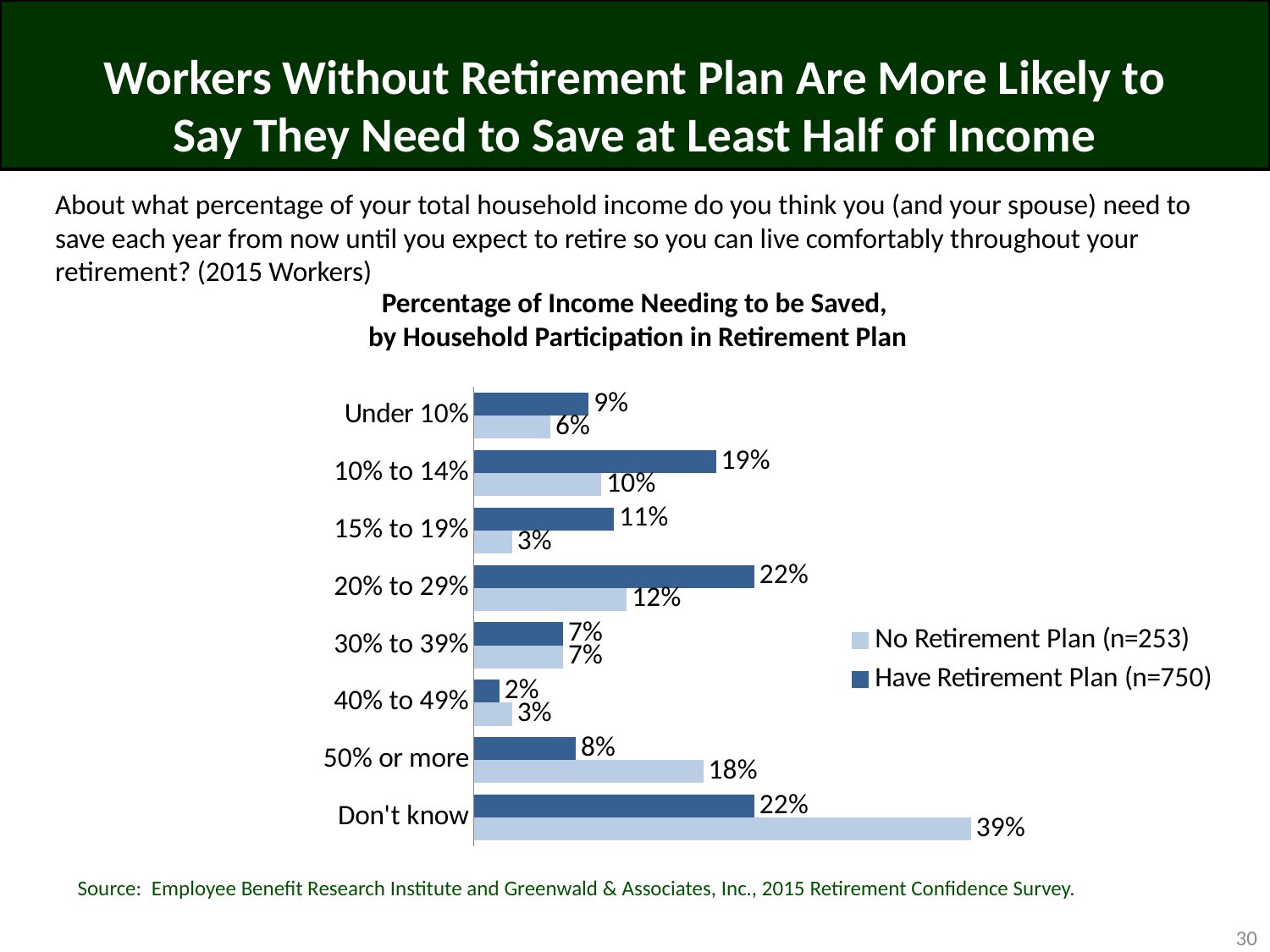
Which category has the lowest value for the Have Retirement Plan series? 40% to 49% What type of chart is shown on the slide? Bar chart How many response categories are shown on the chart? 8 What is the value for the Have Retirement Plan series in the 10% to 14% category? 19% Which category has the highest value for the No Retirement Plan series? Don't know What percentage of workers with no retirement plan answered "Don't know"? 39% According to the legend, what is the sample size for the Have Retirement Plan group? n=750 What is the value for the No Retirement Plan series in the 20% to 29% category? 12% How many series does the legend list? 2 In the 15% to 19% category, which series has the larger value: No Retirement Plan or Have Retirement Plan? Have Retirement Plan In the 50% or more category, what is the difference between the No Retirement Plan value and the Have Retirement Plan value? 10% What percentage of workers who have a retirement plan say they need to save 50% or more of their income? 8%